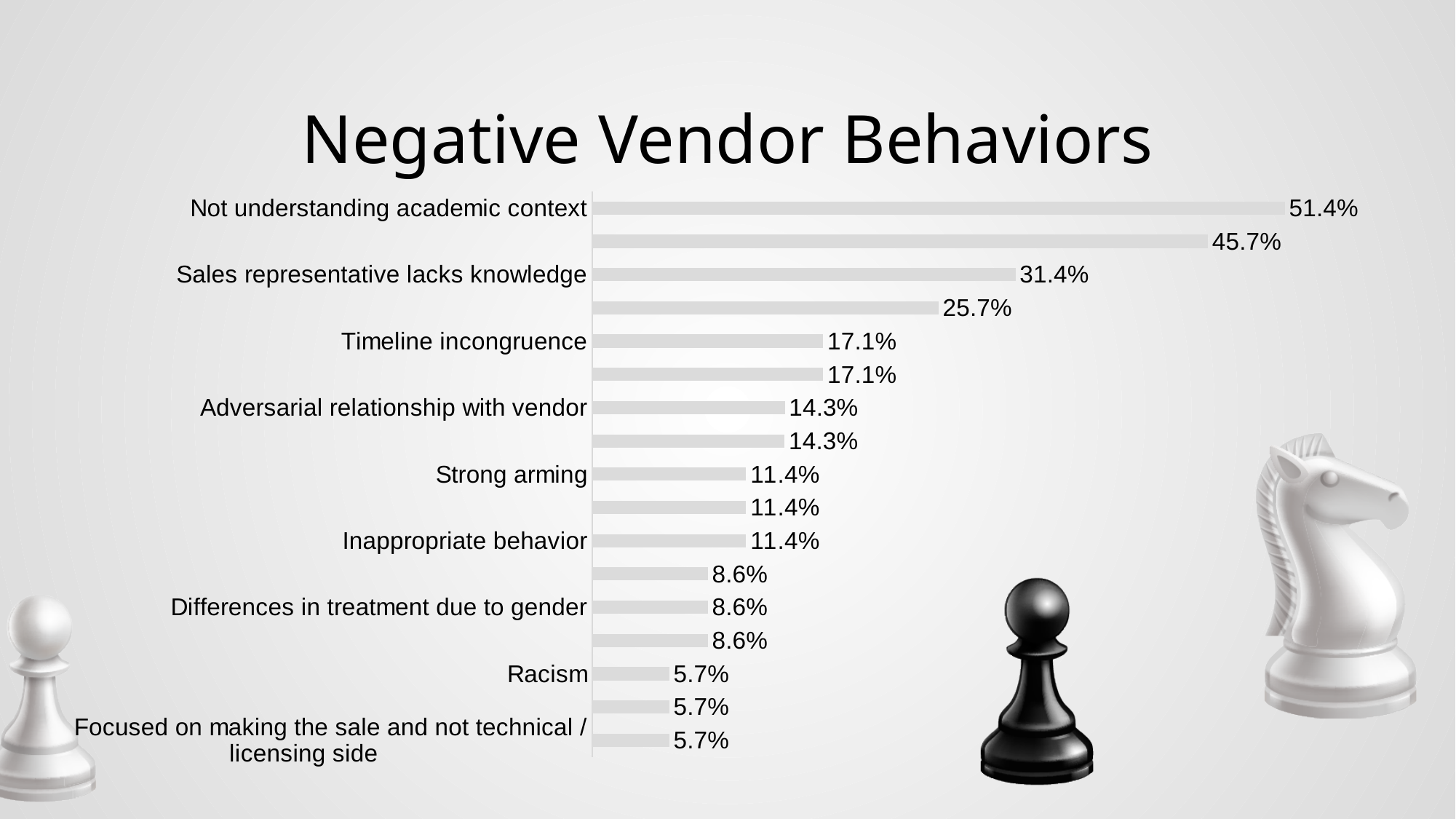
What is the value for Not understanding academic context? 51.4% What is the difference between the values for Not understanding academic context and Sales representative lacks knowledge? 20.0% What is the value for Sales representative lacks knowledge? 31.4% What is the value for Racism? 5.7% How many bars are plotted on the chart? 17 What is the lowest value shown on the chart? 5.7% Which category has the highest value? Not understanding academic context What is the title of the chart? Negative Vendor Behaviors Which is larger, the value for Adversarial relationship with vendor or the value for Strong arming? Adversarial relationship with vendor What is the value for Timeline incongruence? 17.1% What is the value for Differences in treatment due to gender? 8.6% What kind of chart is shown on the slide? bar chart